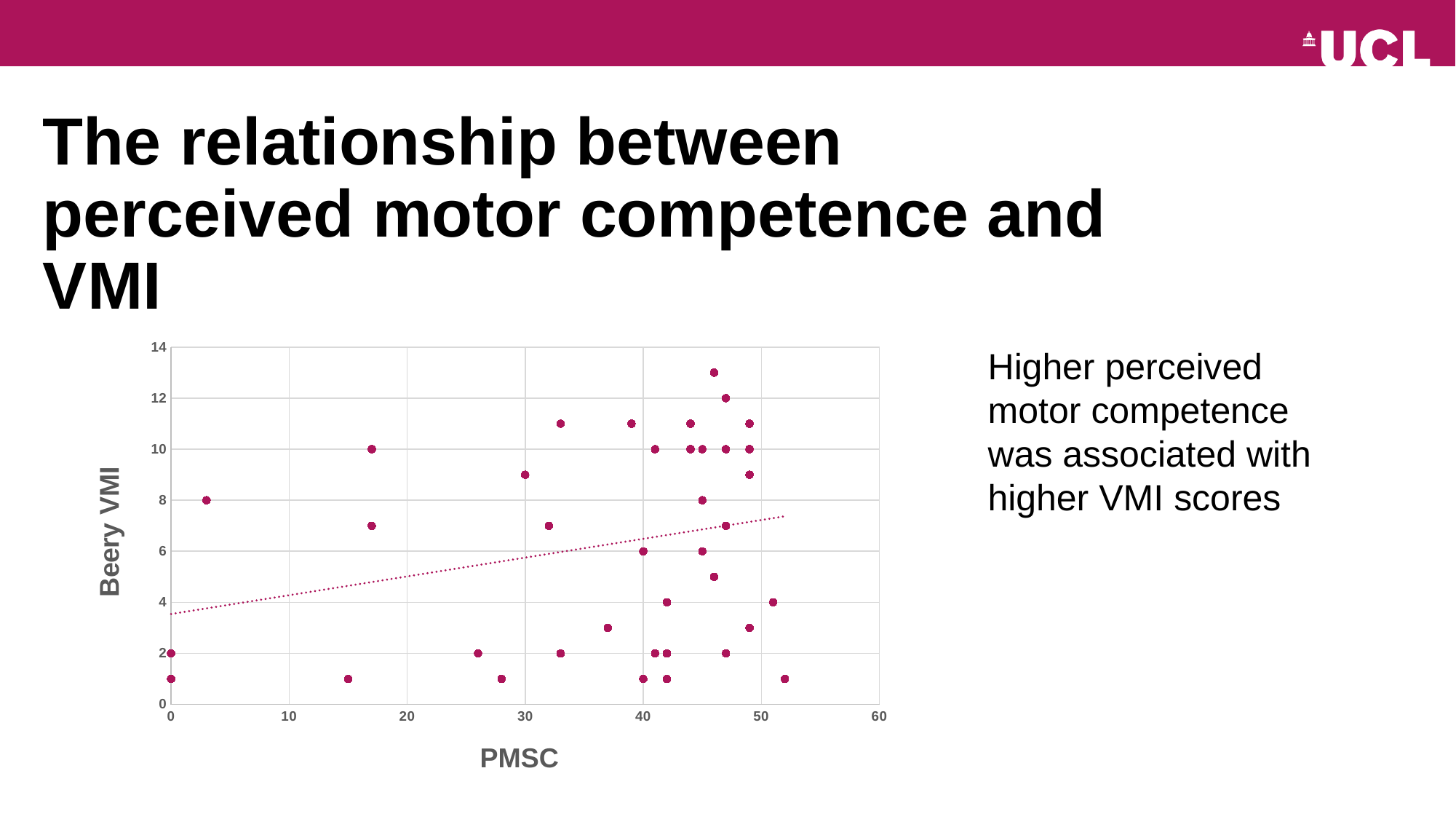
Is the Beery VMI value of the point at PMSC 30 greater or less than 8? greater Is the trend line's Beery VMI value at PMSC 0 greater or less than 4? less Is the Beery VMI value of the highest point greater or less than 12? greater What is the label of the y axis? Beery VMI Does the dotted trend line rise or fall as PMSC increases? rise What is the label of the x axis? PMSC What kind of chart is shown on the slide? scatter plot